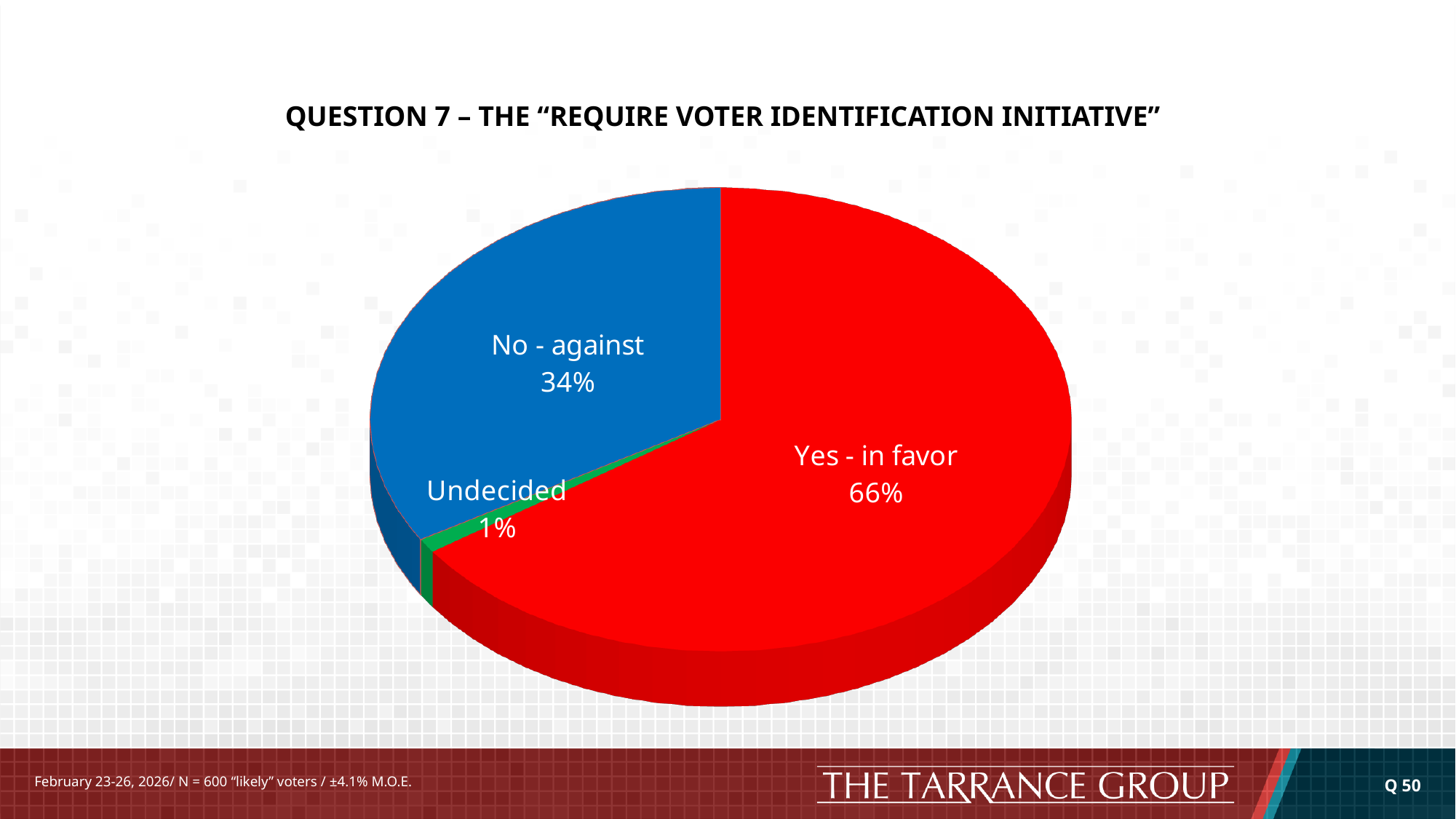
What is the title of the chart? QUESTION 7 – THE "REQUIRE VOTER IDENTIFICATION INITIATIVE" What colour is the "No - against" slice? Blue What percentage of respondents were Undecided? 1% What is the difference in percentage points between "Yes - in favor" and "No - against"? 32 Which response has the largest share of the pie? Yes - in favor What percentage of respondents answered "Yes - in favor"? 66% How many slices does the pie chart have? 3 What share of the pie does the "Yes - in favor" slice represent? 66% What percentage of respondents answered "No - against"? 34% Which is larger, the share for "No - against" or the share for Undecided? No - against Which response has the smallest share of the pie? Undecided What kind of chart is shown on the slide? Pie chart